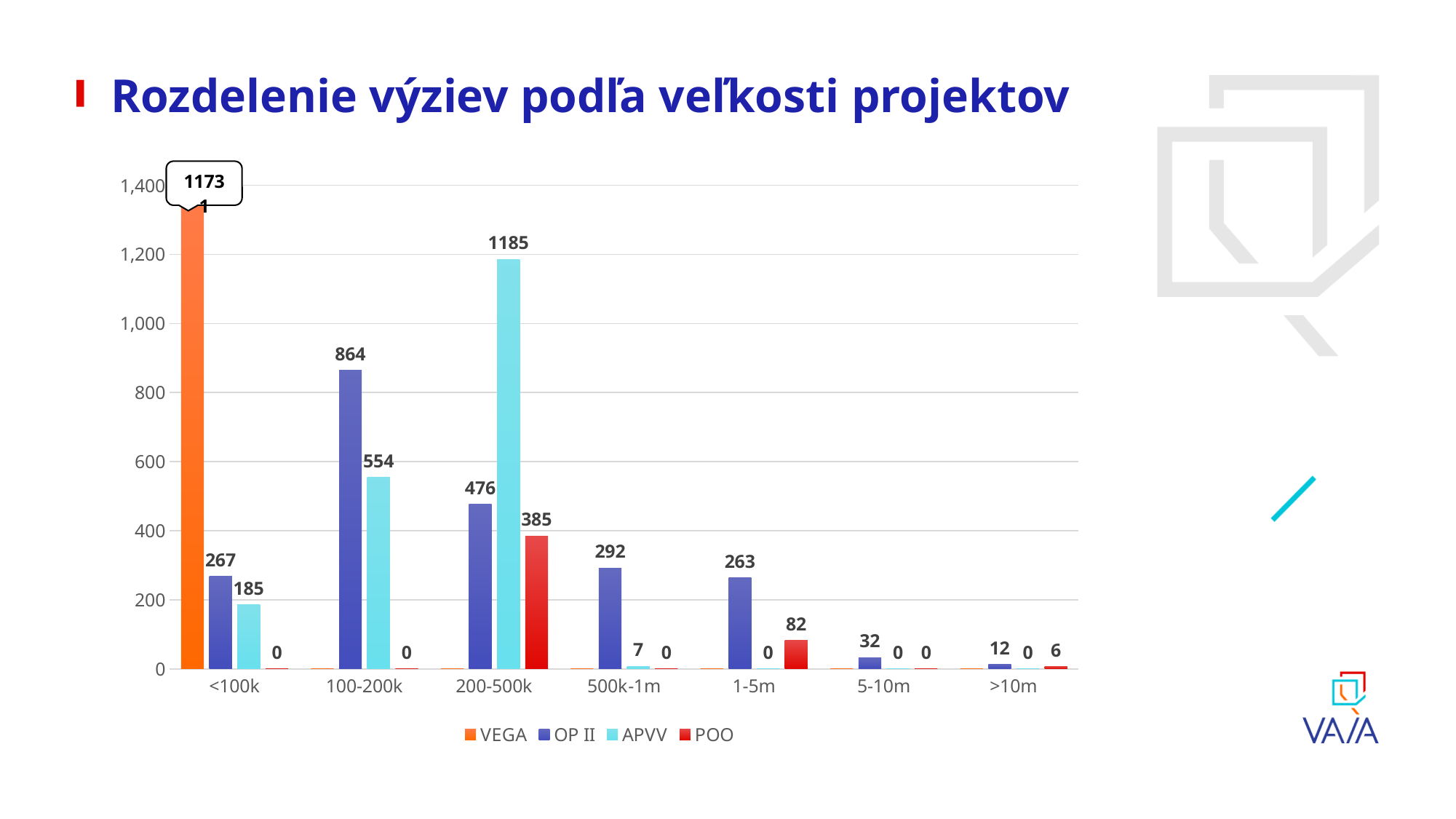
Which category has the highest POO value? 200-500k Is the value for VEGA in the <100k category greater or less than 1,200? greater How many series does the legend list? 4 How many categories are shown on the x axis? 7 Which category has the highest OP II value? 100-200k Which is larger in the 200-500k category, OP II or APVV? APVV What is the difference between the OP II and APVV values in the 100-200k category? 310 What is the value for OP II in the >10m category? 12 What is the value for APVV in the 200-500k category? 1185 What is the value for POO in the 1-5m category? 82 What kind of chart is shown on the slide? bar chart What is the value for OP II in the 100-200k category? 864